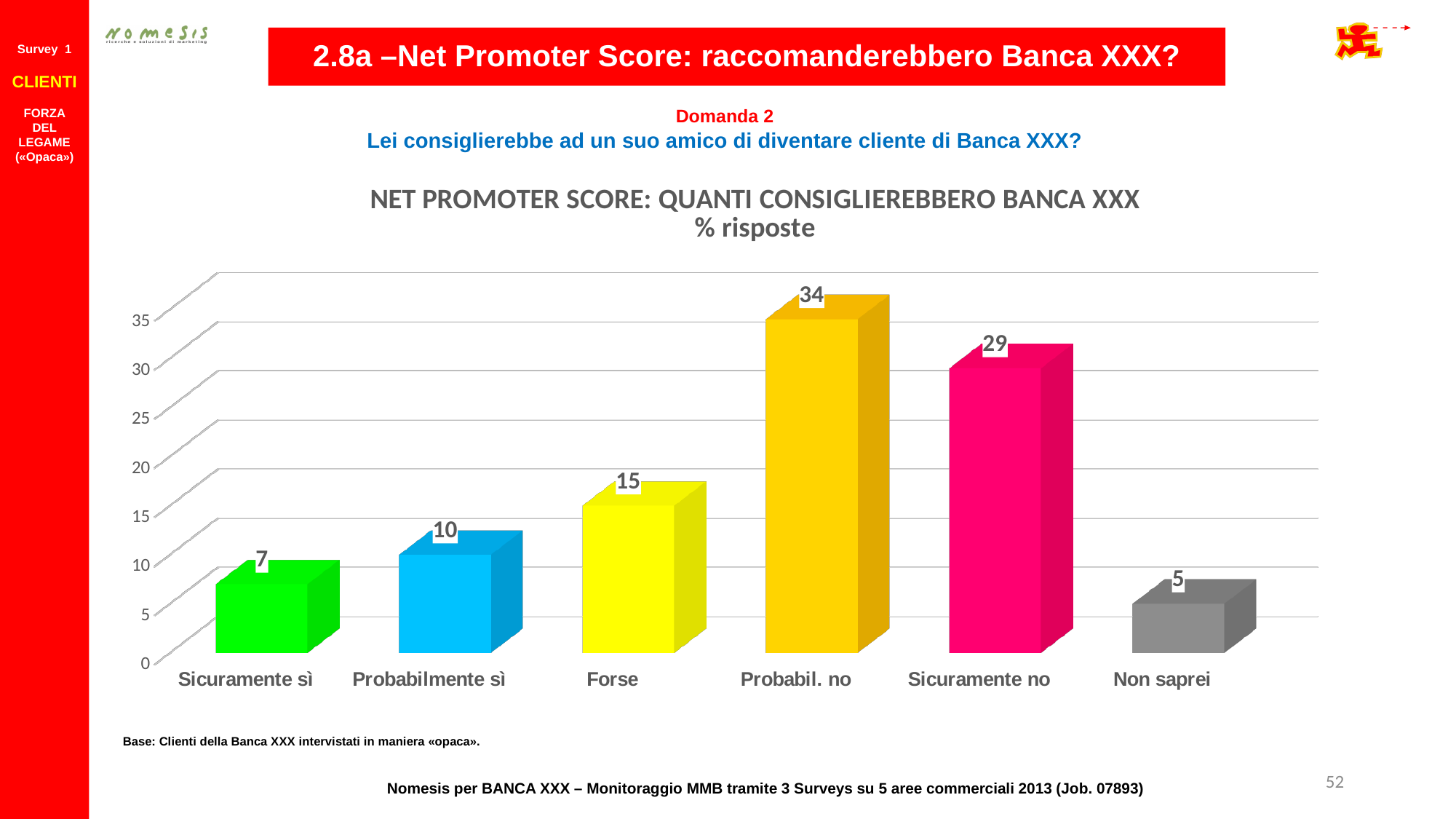
Which is larger, the value for "Forse" or the value for "Probabilmente sì"? Forse Which category has the lowest value? Non saprei What kind of chart is shown? bar chart Which category has the highest value? Probabil. no What is the total of the values for "Sicuramente sì" and "Probabilmente sì"? 17 How many categories are shown on the x axis? 6 What is the value for "Probabil. no"? 34 What is the value for "Sicuramente sì"? 7 What colour is the bar for "Sicuramente no"? pink What is the value for "Non saprei"? 5 Is the value for "Sicuramente no" greater or less than 25? greater What is the difference between the values for "Probabil. no" and "Sicuramente no"? 5